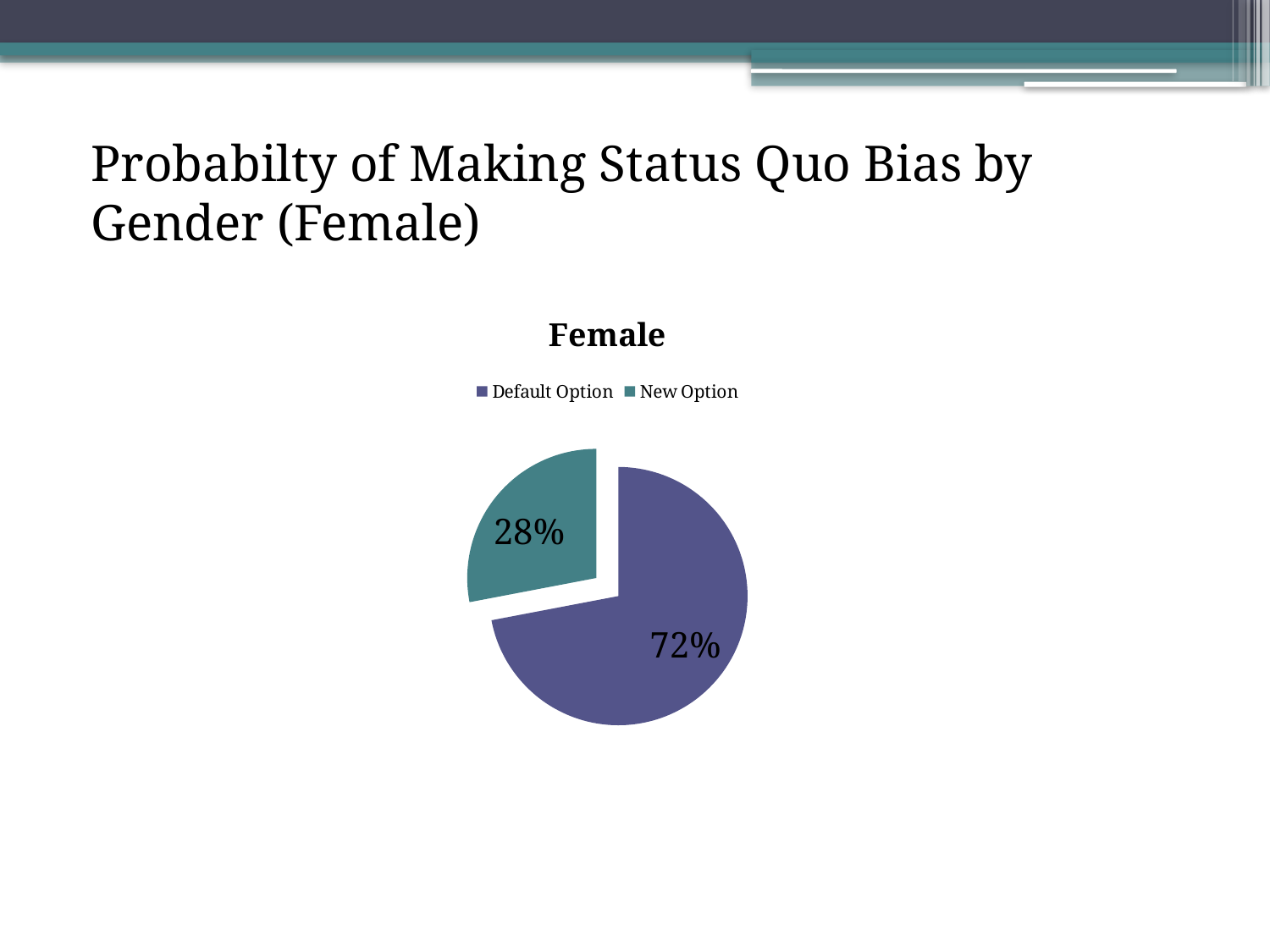
Which slice is the largest? Default Option What colour is the New Option slice? teal Which is larger, Default Option or New Option? Default Option What share of the pie does Default Option take? 72% How many entries does the legend list? 2 What share of the pie does New Option take? 28% What is the difference in percentage points between Default Option and New Option? 44 What is the title of the chart? Female How many slices does the pie chart have? 2 What type of chart is shown on the slide? pie chart Which slice is the smallest? New Option